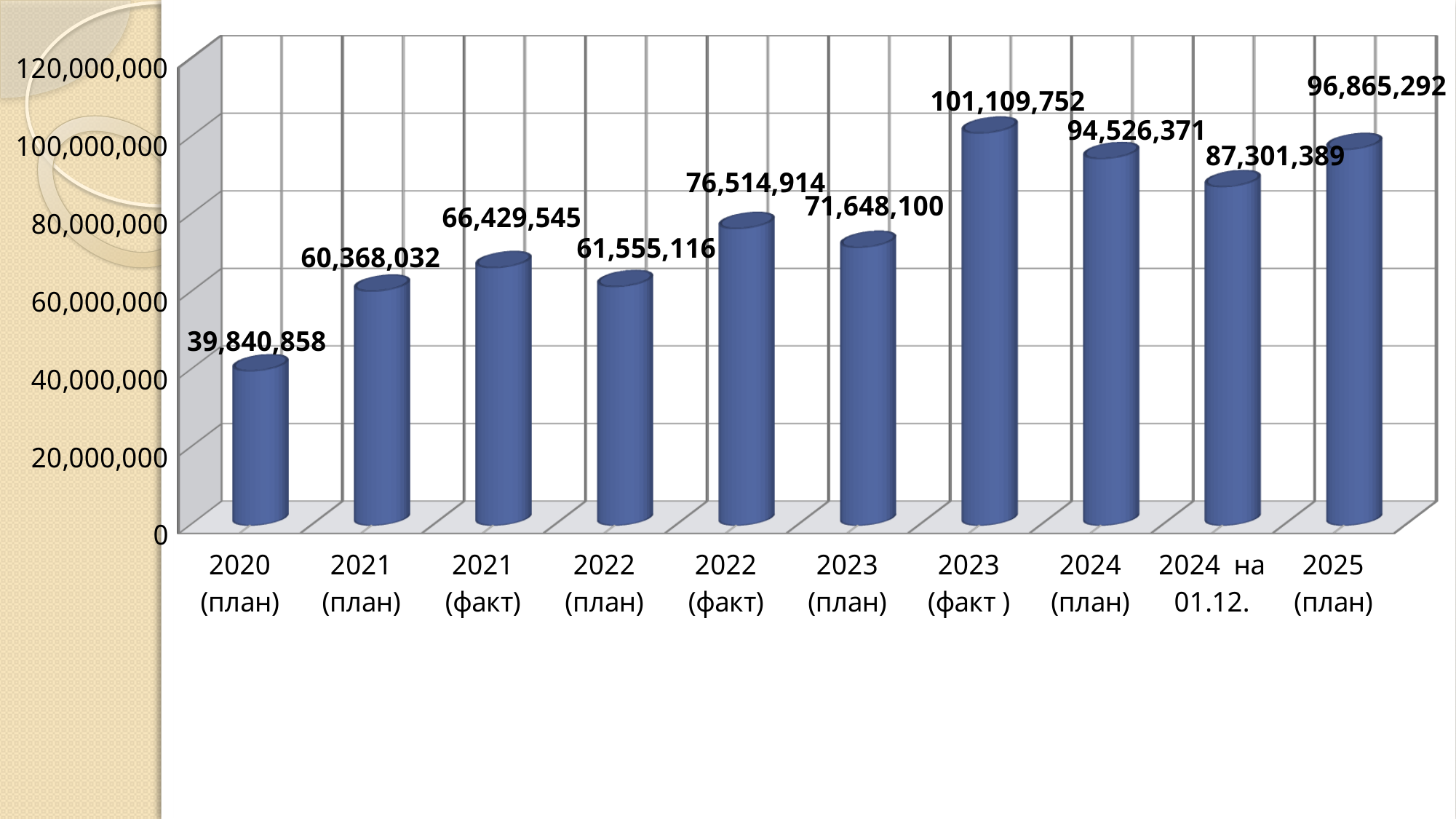
What is the difference between 2023 (факт) and 2023 (план)? 29,461,652 What is the value for 2025 (план)? 96,865,292 What is the value for 2023 (факт)? 101,109,752 Which is larger, the value for 2022 (факт) or the value for 2023 (план)? 2022 (факт) Is the value for 2024 (план) greater or less than 80,000,000? greater How many bars are shown in the chart? 10 Which category has the lowest value? 2020 (план) What kind of chart is shown on the slide? bar chart What is the difference between 2021 (факт) and 2021 (план)? 6,061,513 What is the value for 2024 на 01.12.? 87,301,389 What is the value for 2020 (план)? 39,840,858 Which category has the highest value? 2023 (факт)